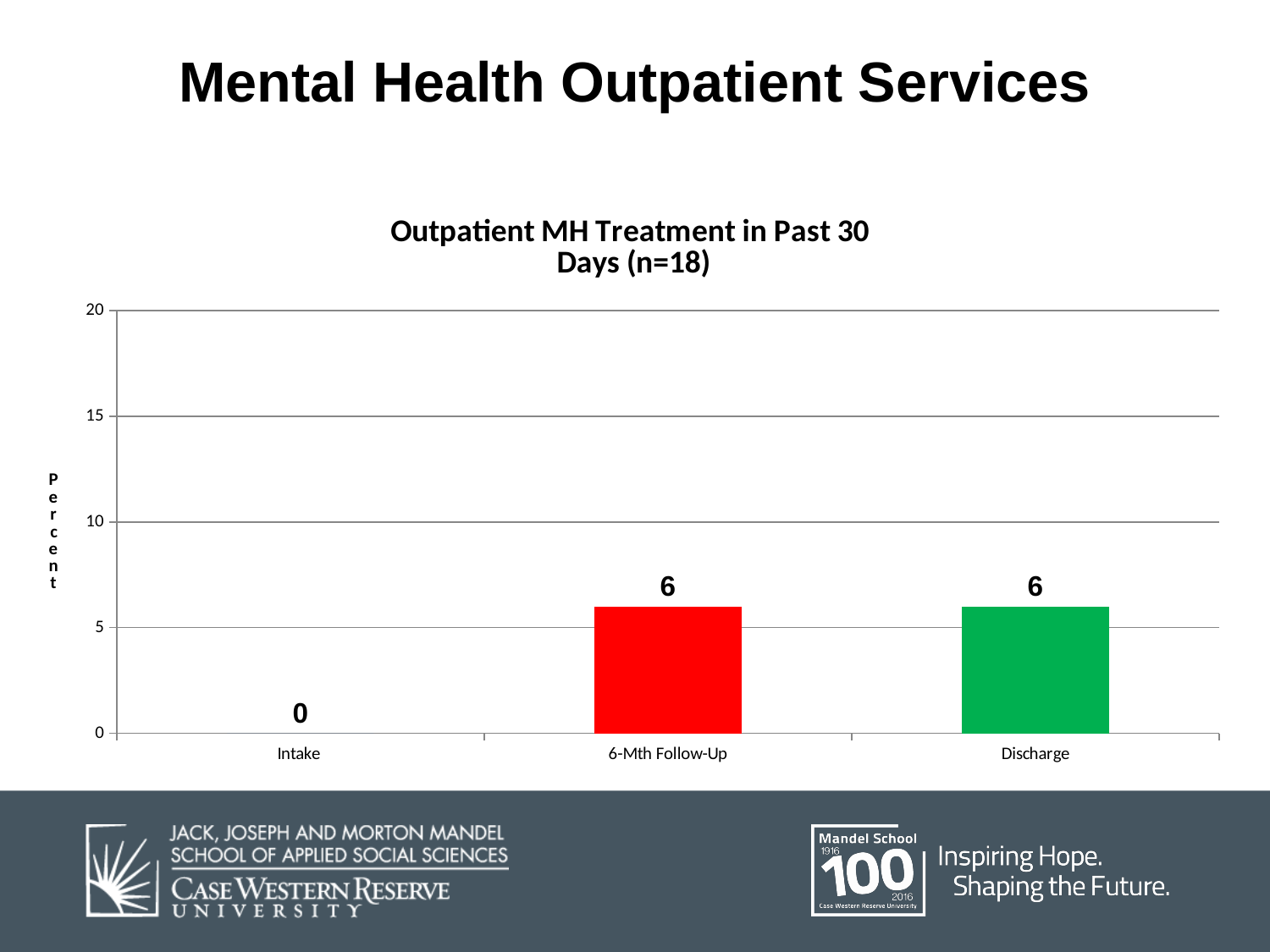
What is the title of the chart? Outpatient MH Treatment in Past 30 Days (n=18) How many categories are shown on the x axis? 3 What is the value for 6-Mth Follow-Up? 6 What is the label on the y axis? Percent What is the difference between the values for Discharge and Intake? 6 Is the value for Discharge greater or less than 10? less Which is larger, the value for Intake or the value for 6-Mth Follow-Up? 6-Mth Follow-Up Which category has the lowest value? Intake What is the value for Discharge? 6 What kind of chart is shown? bar chart What is the value for Intake? 0 Do the values for 6-Mth Follow-Up and Discharge differ? No, both are 6